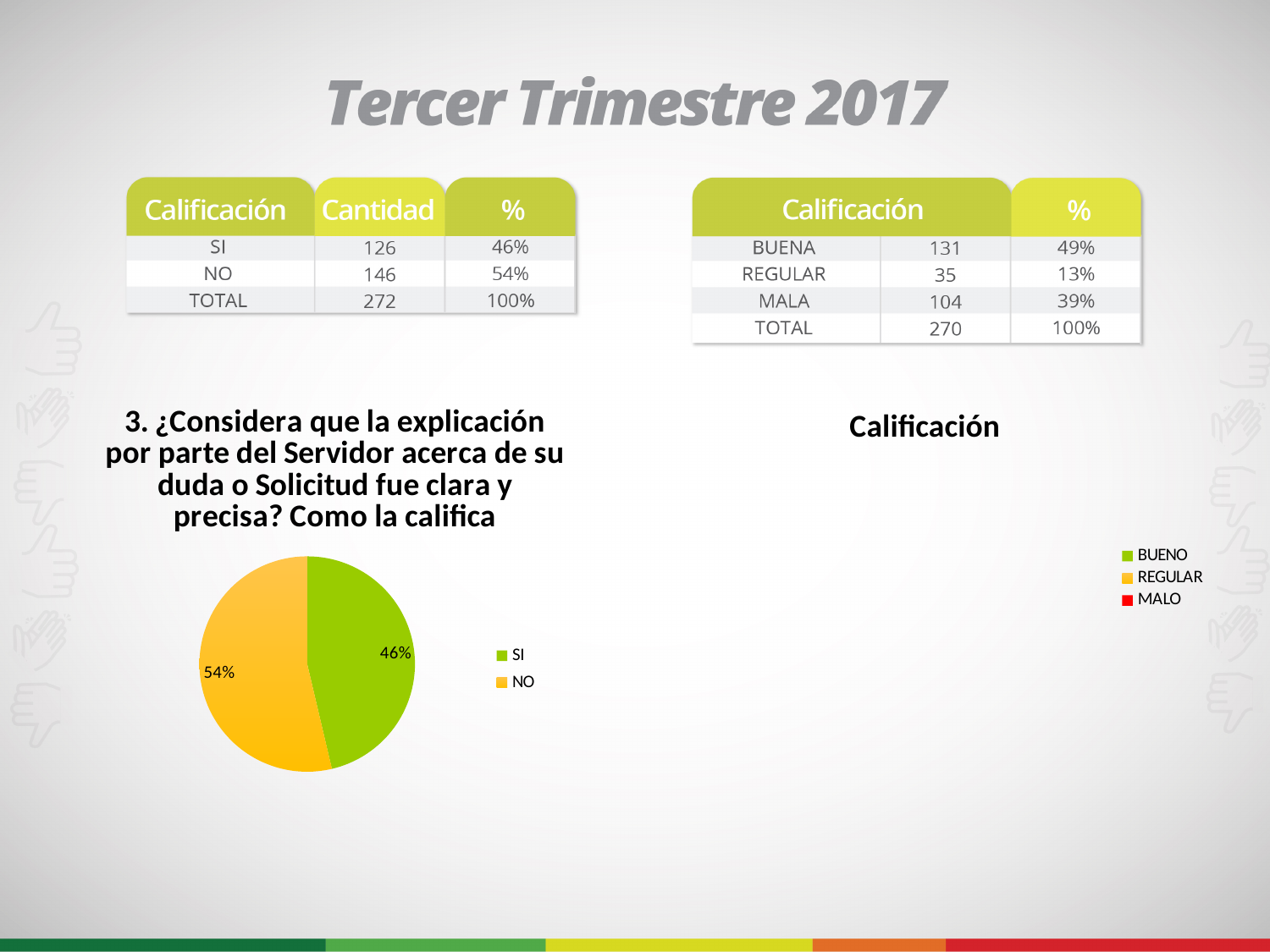
In the pie chart on the left, which slice is the smallest? SI In the pie chart on the left, what share is labelled for SI? 46% In the pie chart on the left, what colour is the SI slice? green In the pie chart on the left, which is larger, the SI slice or the NO slice? NO In the pie chart on the left, what is the difference in percentage points between the NO slice and the SI slice? 8 In the pie chart on the left, what share is labelled for NO? 54% What kind of chart is the chart on the left of the slide? pie chart How many entries does the legend of the chart titled "Calificación" on the right list? 3 How many entries does the legend of the pie chart on the left list? 2 How many slices does the pie chart on the left have? 2 In the pie chart on the left, which slice is the largest? NO What is the title of the chart on the right of the slide? Calificación